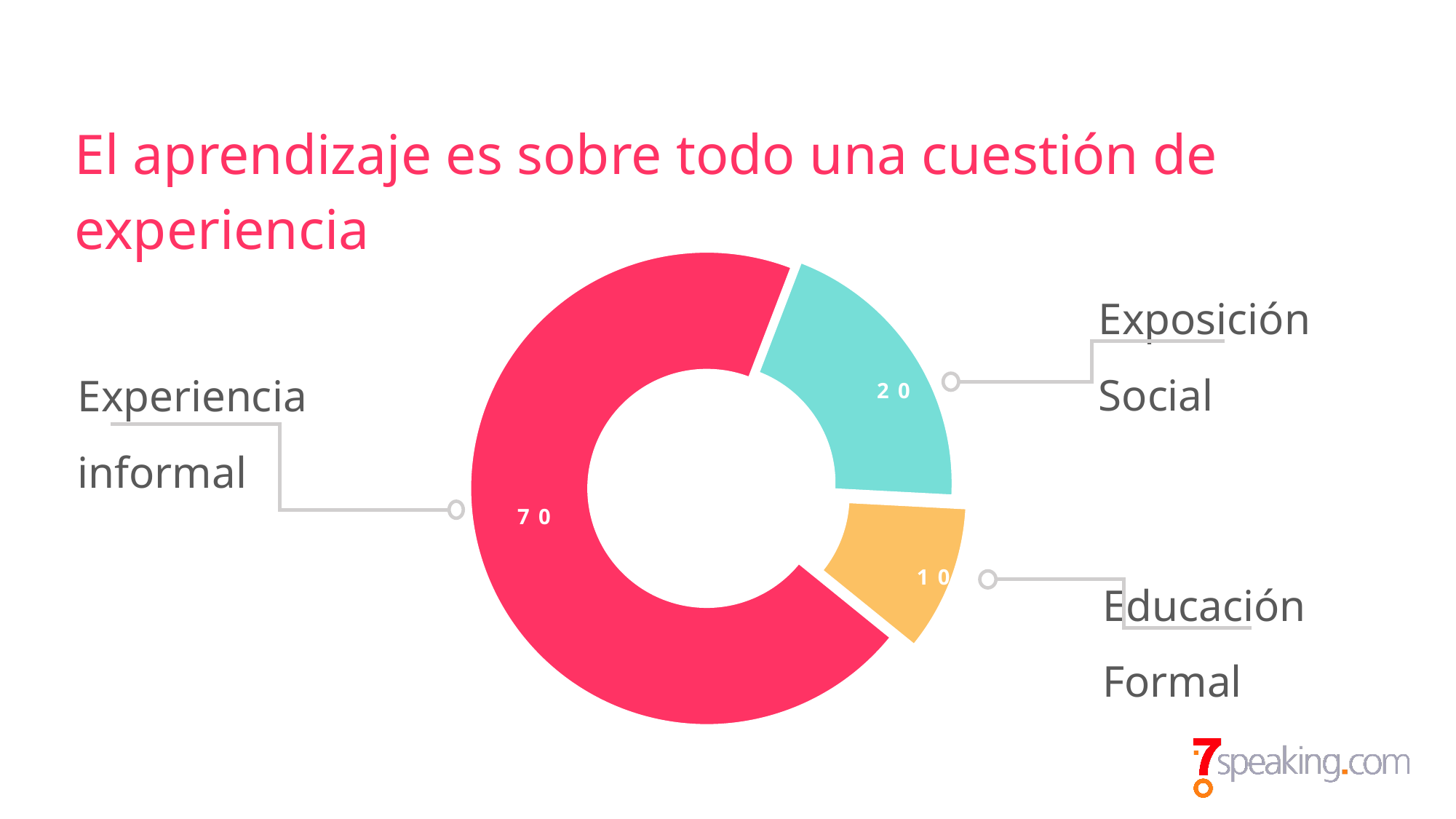
How many categories are shown in the chart? 3 Which is larger, the value for Exposición Social or the value for Educación Formal? Exposición Social What is the difference between the values for Experiencia informal and Exposición Social? 50 What share of the total does Experiencia informal represent? 70% What value is shown for Experiencia informal? 70 What kind of chart is shown on the slide? Doughnut chart Which category has the smallest slice? Educación Formal What value is shown for Exposición Social? 20 Which category has the largest slice? Experiencia informal What colour is the slice for Exposición Social? Teal What value is shown for Educación Formal? 10 What is the difference between the values for Exposición Social and Educación Formal? 10